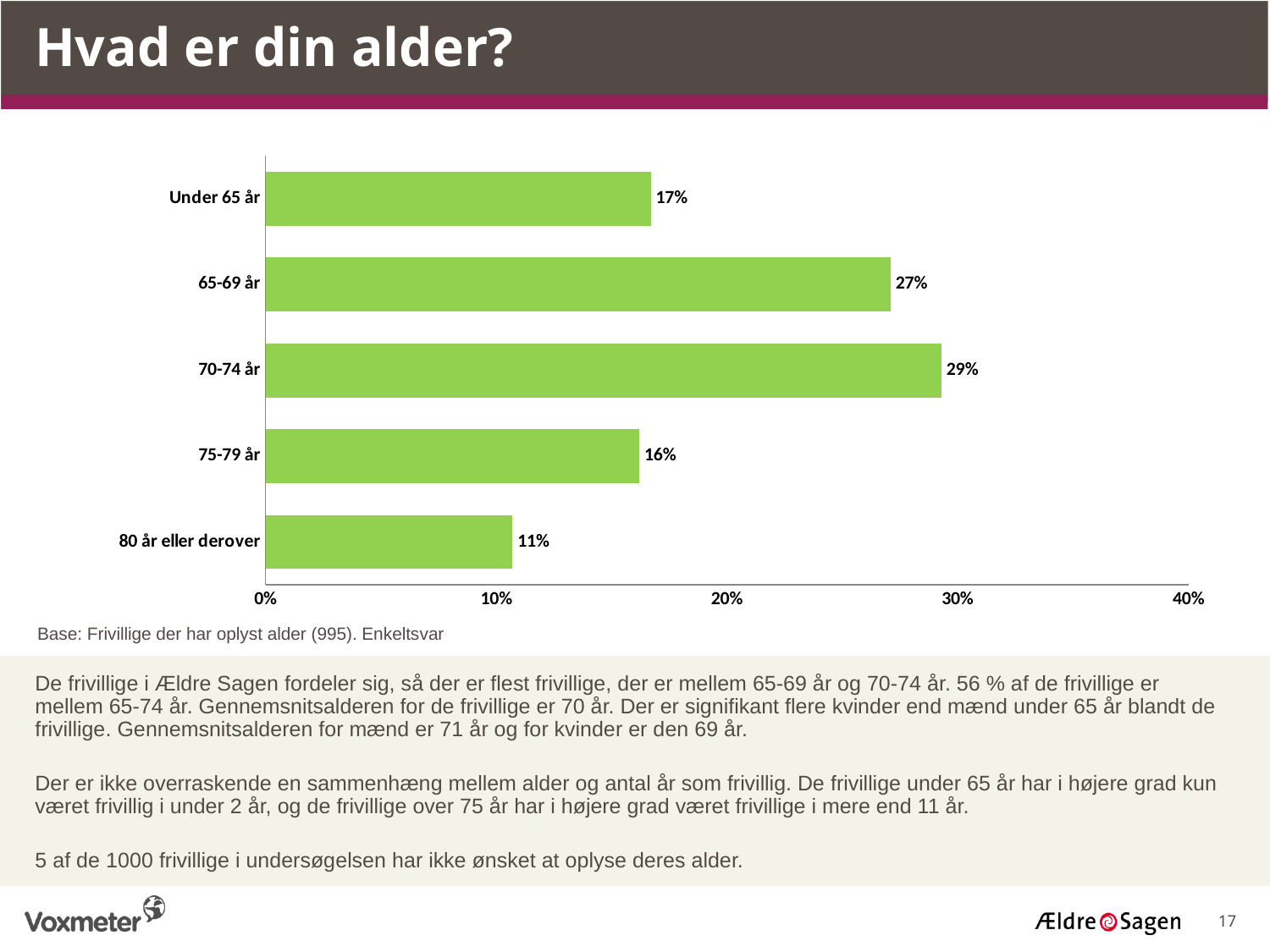
Which age category has the lowest value? 80 år eller derover What kind of chart is shown on the slide? Bar chart What is the title of the slide containing the chart? Hvad er din alder? What is the difference between the values for 65-69 år and 75-79 år? 11 percentage points What is the value for the 70-74 år category? 29% How many age categories are shown in the chart? 5 Which age category has the highest value? 70-74 år What is the highest value shown on the horizontal axis? 40% Is the value for 65-69 år greater or less than 20%? greater What is the value for the Under 65 år category? 17% Which is larger, the value for Under 65 år or the value for 75-79 år? Under 65 år What is the value for the 80 år eller derover category? 11%